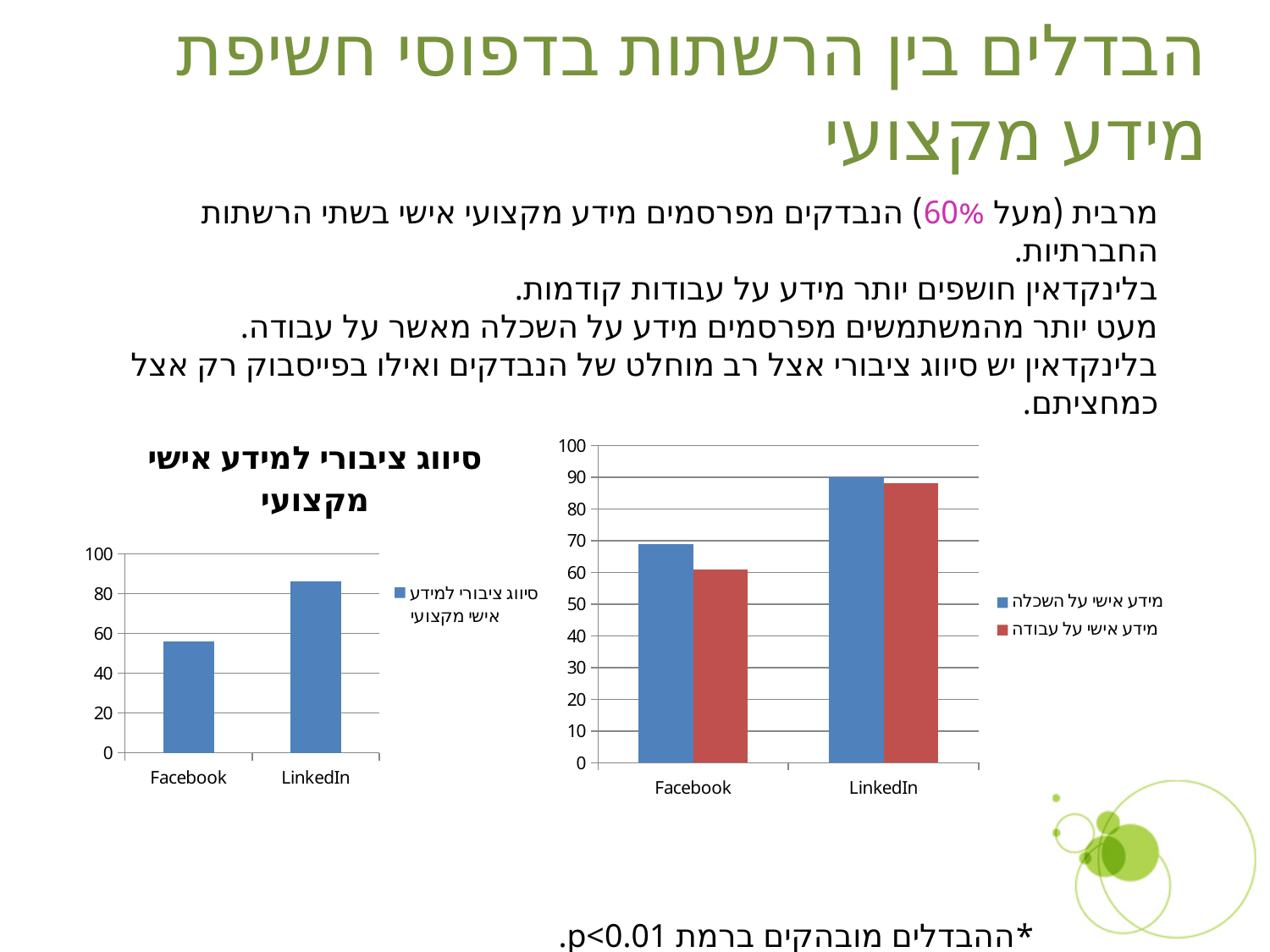
In the left chart titled "סיווג ציבורי למידע אישי מקצועי", is the value for Facebook greater or less than 60? less In the left chart titled "סיווג ציבורי למידע אישי מקצועי", which category has the lower value? Facebook In the right chart, which is larger for Facebook: "מידע אישי על השכלה" or "מידע אישי על עבודה"? מידע אישי על השכלה What kind of chart is the left chart titled "סיווג ציבורי למידע אישי מקצועי"? bar chart How many series does the legend of the right chart list? 2 What kind of chart is the right chart with the two series? bar chart In the right chart, is the value of "מידע אישי על השכלה" for Facebook greater or less than 60? greater In the right chart, is the value of "מידע אישי על עבודה" for LinkedIn greater or less than 80? greater How many categories are shown on the x axis of the left chart titled "סיווג ציבורי למידע אישי מקצועי"? 2 In the right chart, which colour represents the series "מידע אישי על עבודה"? red In the left chart titled "סיווג ציבורי למידע אישי מקצועי", which category has the higher value? LinkedIn